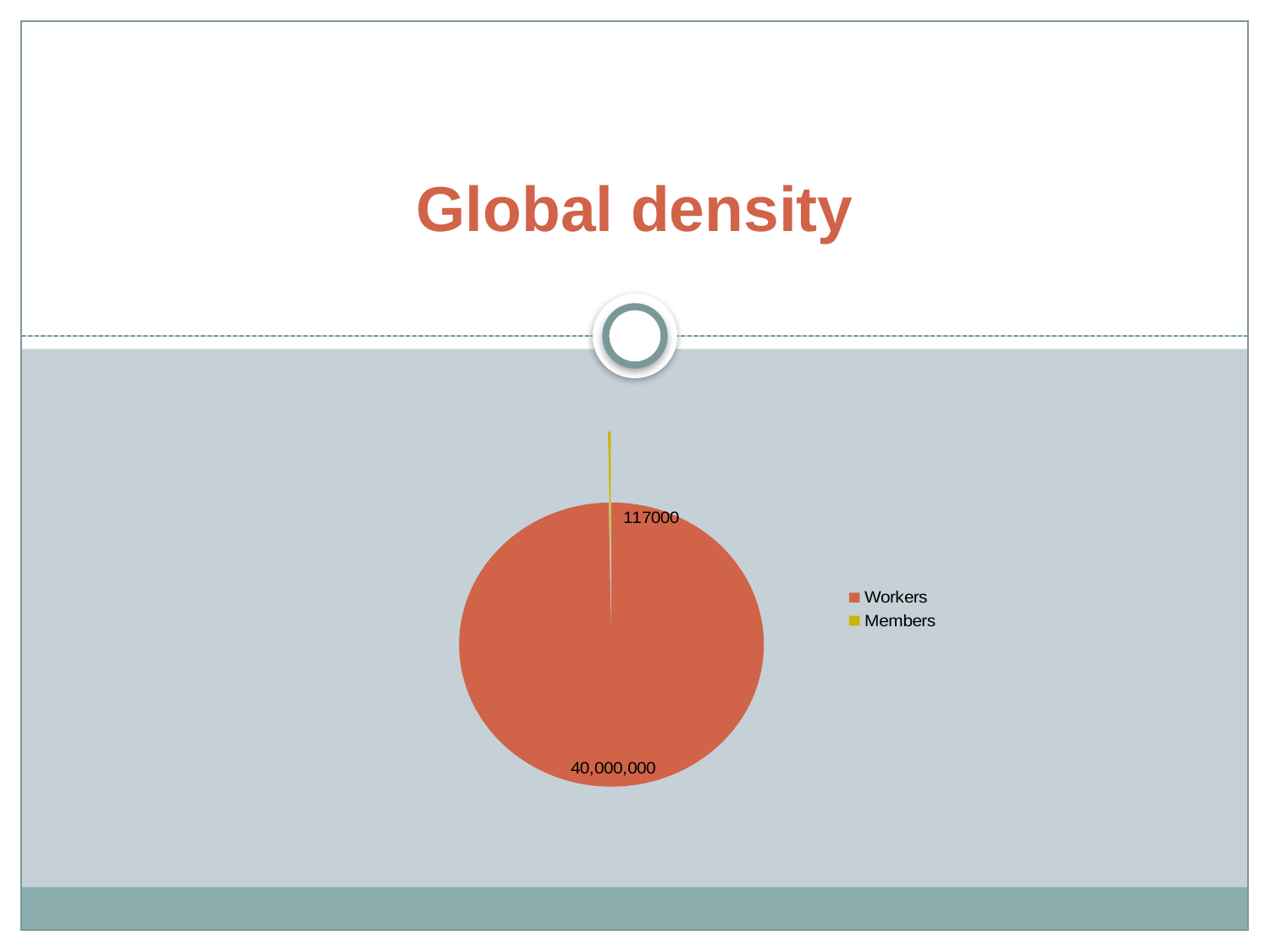
What is the title of the slide containing the pie chart? Global density What is the value for Workers in the pie chart? 40,000,000 What colour is the Members slice in the pie chart? Yellow How many slices does the pie chart have? 2 How many entries does the legend list? 2 What is the value for Members in the pie chart? 117000 What type of chart is shown on the slide? Pie chart What is the total of the two values shown in the pie chart? 40,117,000 Which category has the largest slice in the pie chart? Workers Which is larger, the value for Workers or the value for Members? Workers What is the difference between the Workers value and the Members value? 39,883,000 Which category has the smallest slice in the pie chart? Members